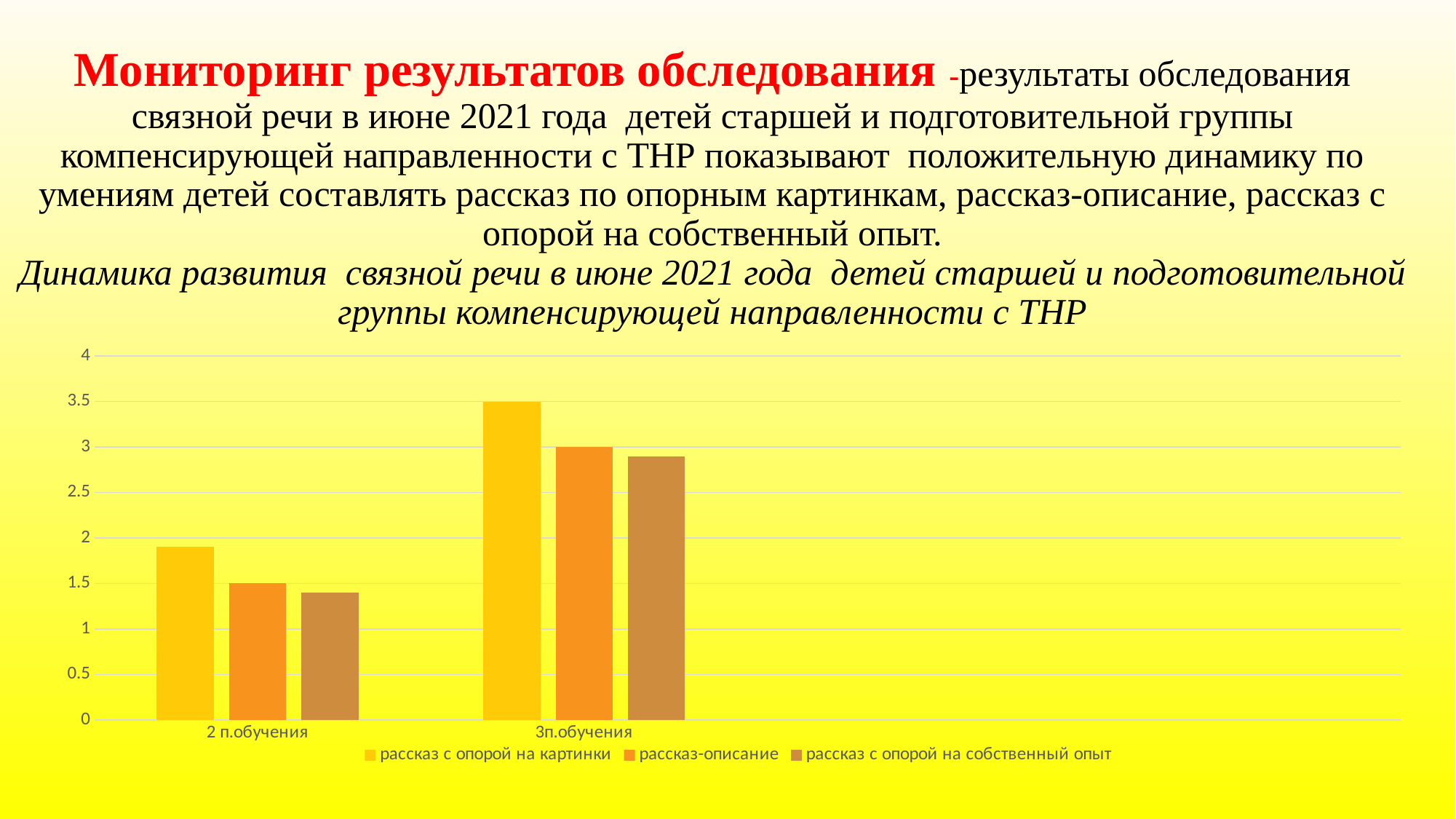
How many series does the legend list? 3 How many categories are shown on the x axis? 2 What is the value for 'рассказ-описание' at '2 п.обучения'? 1.5 Which series has the highest value at '3п.обучения'? рассказ с опорой на картинки Is the value for 'рассказ с опорой на собственный опыт' at '2 п.обучения' greater or less than 1.5? less Is the value for 'рассказ с опорой на собственный опыт' at '3п.обучения' greater or less than 2.5? greater What is the value for 'рассказ-описание' at '3п.обучения'? 3 Do the values for 'рассказ-описание' rise or fall from '2 п.обучения' to '3п.обучения'? rise Which series has the lowest value at '2 п.обучения'? рассказ с опорой на собственный опыт What is the value for 'рассказ с опорой на картинки' at '3п.обучения'? 3.5 What kind of chart is shown on the slide? bar chart Is the value for 'рассказ с опорой на картинки' at '2 п.обучения' greater or less than 1.5? greater